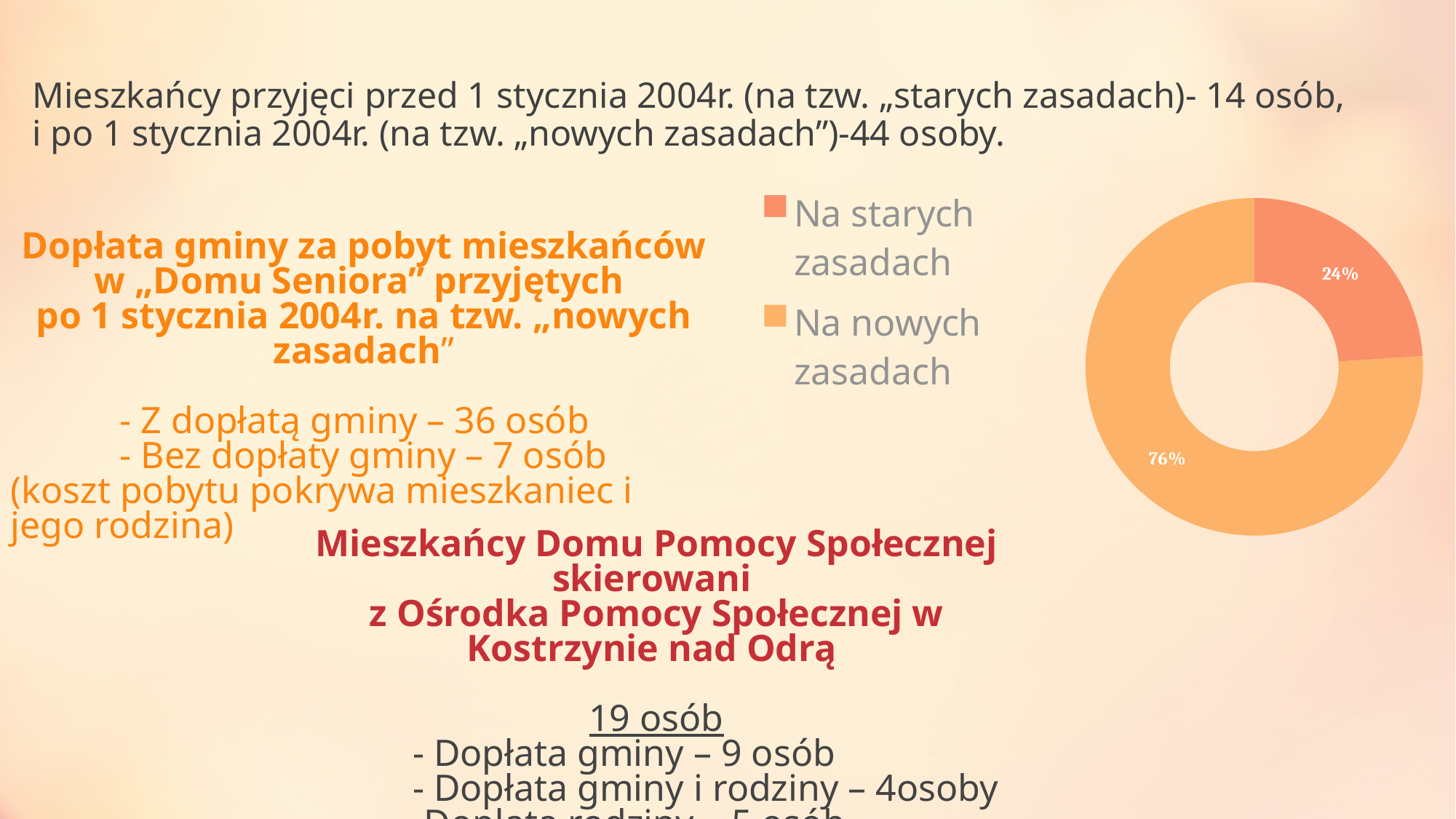
What kind of chart is shown on the slide? Doughnut (pie) chart How many slices does the doughnut chart have? 2 Which legend entry is shown in the lighter orange colour? Na nowych zasadach Which is larger in the doughnut chart: "Na starych zasadach" or "Na nowych zasadach"? Na nowych zasadach Which slice of the doughnut chart is the smallest? Na starych zasadach What is the difference in percentage points between the "Na nowych zasadach" slice and the "Na starych zasadach" slice? 52 What share of the doughnut chart is labelled "Na starych zasadach"? 24% Which slice of the doughnut chart is the largest? Na nowych zasadach What share of the doughnut chart is labelled "Na nowych zasadach"? 76% What is the total of the two percentages shown on the doughnut chart? 100% Which legend entry is shown in the darker orange colour? Na starych zasadach How many entries does the chart legend list? 2